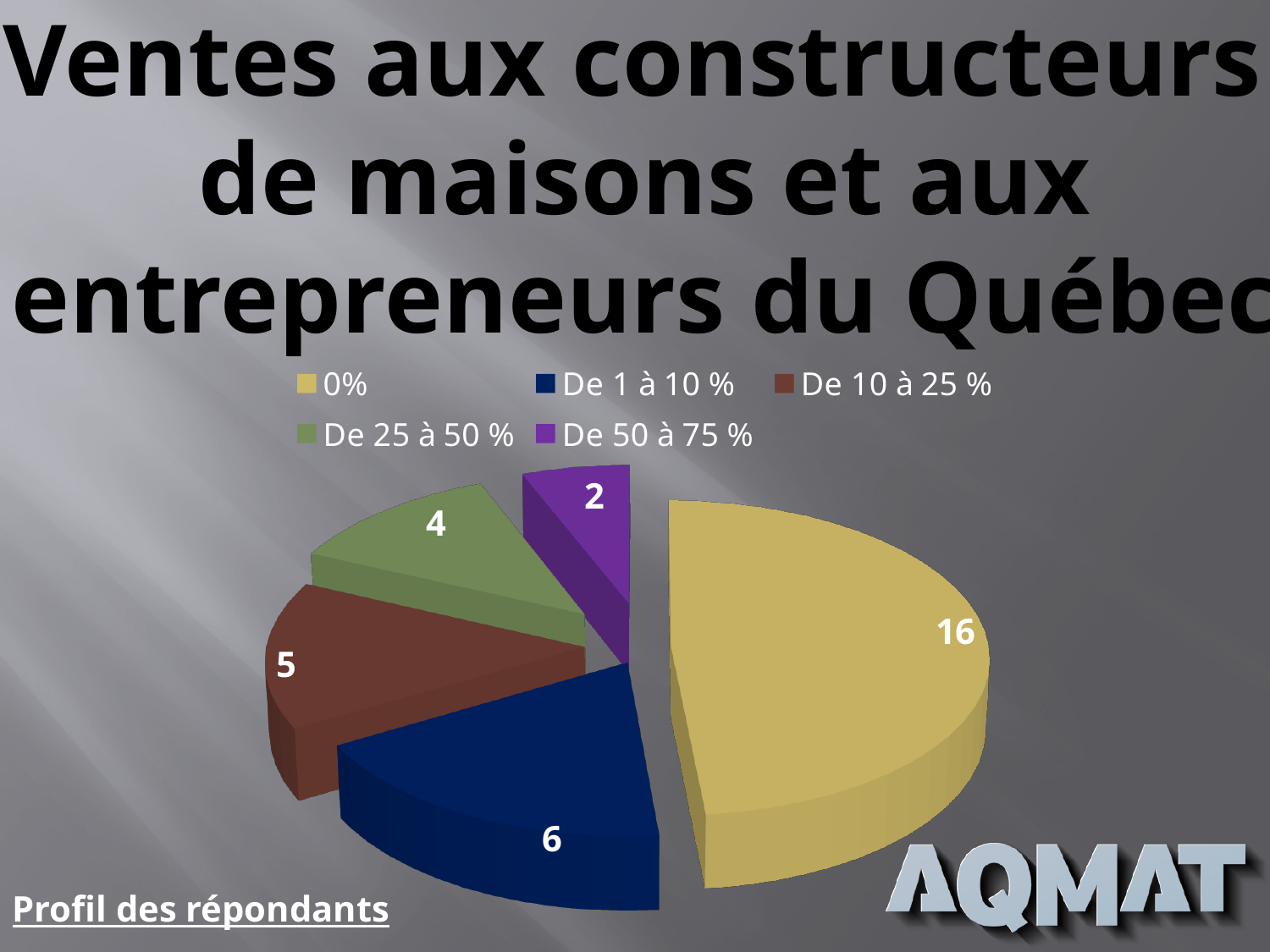
What is the value for the "De 50 à 75 %" slice? 2 What is the value for the "0%" slice? 16 Which category has the largest slice? 0% What is the difference between the "0%" slice and the "De 1 à 10 %" slice? 10 Which category has the smallest slice? De 50 à 75 % What is the total of all the slice values? 33 What colour is the "De 1 à 10 %" slice? dark blue What type of chart is shown on the slide? pie chart How many slices does the pie chart have? 5 What is the value for the "De 1 à 10 %" slice? 6 What is the value for the "De 10 à 25 %" slice? 5 Which is larger, the "De 25 à 50 %" slice or the "De 10 à 25 %" slice? De 10 à 25 %